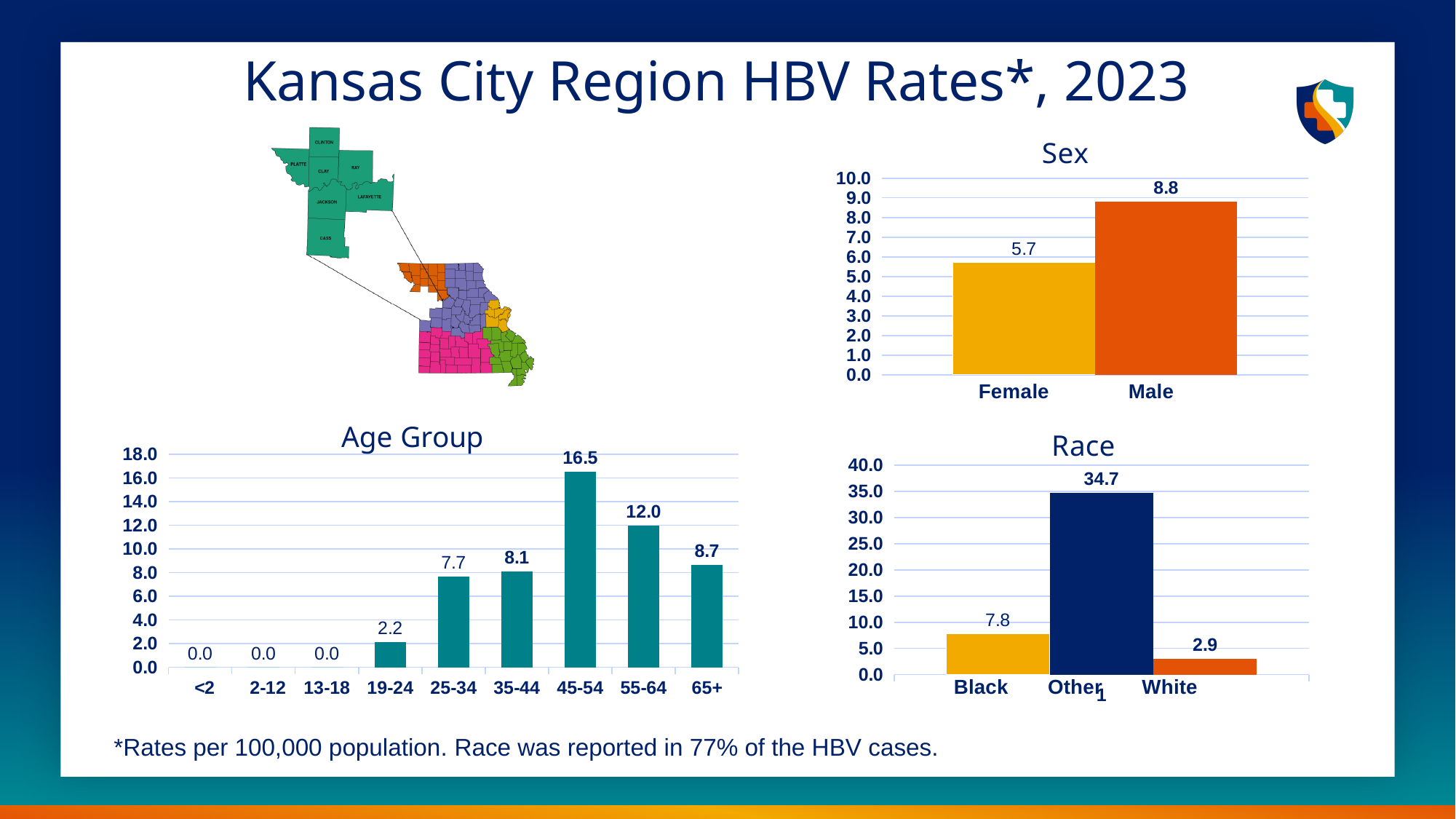
In the Sex chart, what is the difference between the Male and Female rates? 3.1 In the Race chart, which category has the lowest rate? White In the Age Group chart, what is the difference between the rates for 45-54 and 65+? 7.8 In the Sex chart, what is the HBV rate for Female? 5.7 In the Age Group chart, which is larger, the rate for 25-34 or the rate for 35-44? 35-44 In the Age Group chart, what is the rate for the 55-64 age group? 12.0 In the Race chart, what is the rate for White? 2.9 In the Age Group chart, which age group has the highest rate? 45-54 In the Sex chart, what is the HBV rate for Male? 8.8 What kind of chart is the Race chart? Bar chart In the Race chart, which category has the highest rate? Other In the Age Group chart, how many age groups are shown on the x axis? 9